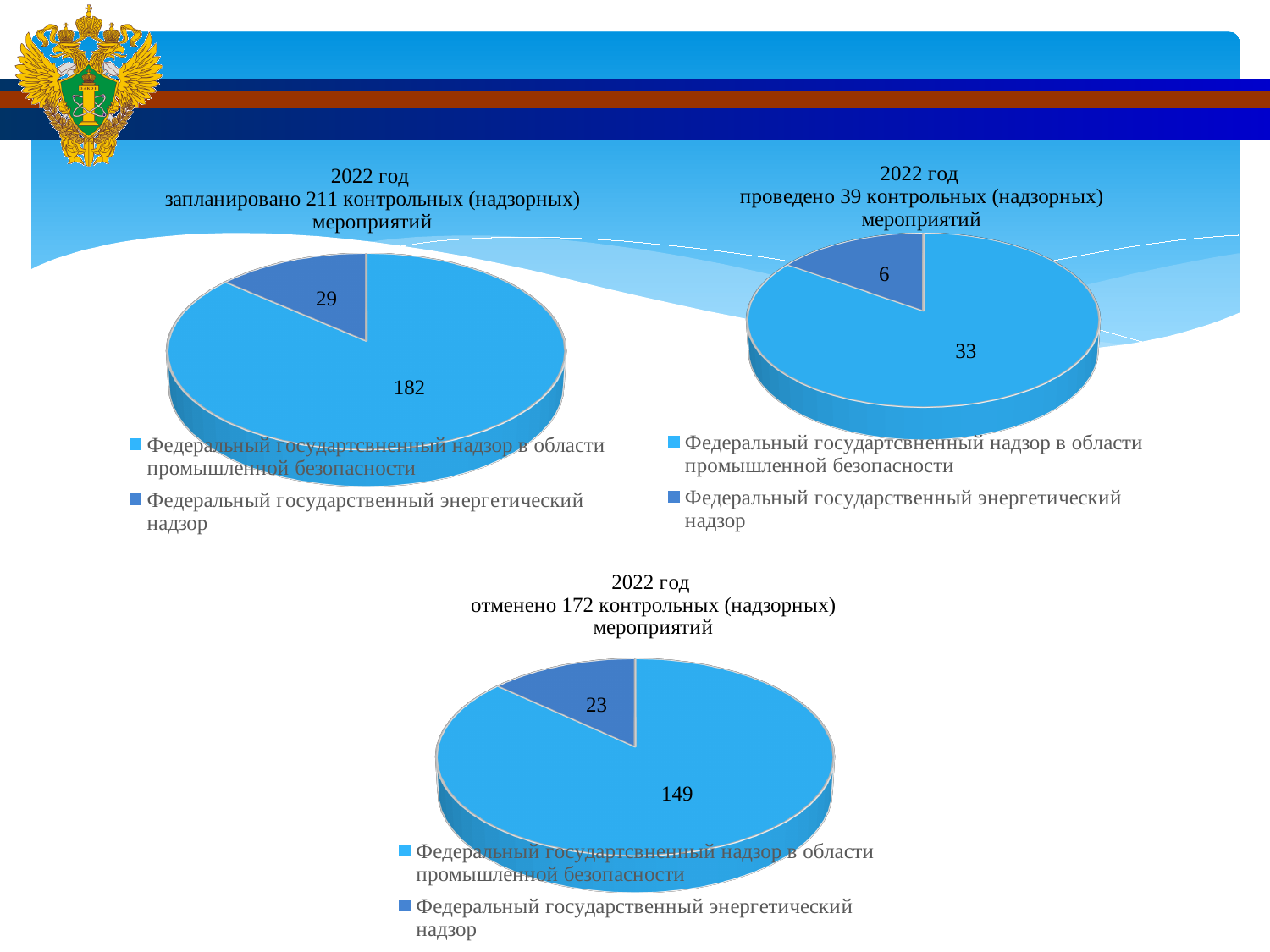
What type of chart is the one titled '2022 год отменено 172 контрольных (надзорных) мероприятий'? Pie chart In the chart titled '2022 год запланировано 211 контрольных (надзорных) мероприятий', what is the value for Федеральный государственный энергетический надзор? 29 In the chart titled '2022 год проведено 39 контрольных (надзорных) мероприятий', which category has the smallest slice? Федеральный государственный энергетический надзор In the chart titled '2022 год запланировано 211 контрольных (надзорных) мероприятий', what is the value for Федеральный государственный надзор в области промышленной безопасности? 182 How many categories does the legend of the chart titled '2022 год проведено 39 контрольных (надзорных) мероприятий' list? 2 In the chart titled '2022 год отменено 172 контрольных (надзорных) мероприятий', what is the difference between the two slices? 126 In the chart titled '2022 год запланировано 211 контрольных (надзорных) мероприятий', what is the difference between the two slices? 153 In the chart titled '2022 год отменено 172 контрольных (надзорных) мероприятий', what is the value for Федеральный государственный энергетический надзор? 23 In the chart titled '2022 год отменено 172 контрольных (надзорных) мероприятий', which category has the largest slice? Федеральный государственный надзор в области промышленной безопасности In the chart titled '2022 год отменено 172 контрольных (надзорных) мероприятий', what is the value for Федеральный государственный надзор в области промышленной безопасности? 149 In the chart titled '2022 год проведено 39 контрольных (надзорных) мероприятий', what is the value for Федеральный государственный надзор в области промышленной безопасности? 33 In the chart titled '2022 год проведено 39 контрольных (надзорных) мероприятий', what is the value for Федеральный государственный энергетический надзор? 6